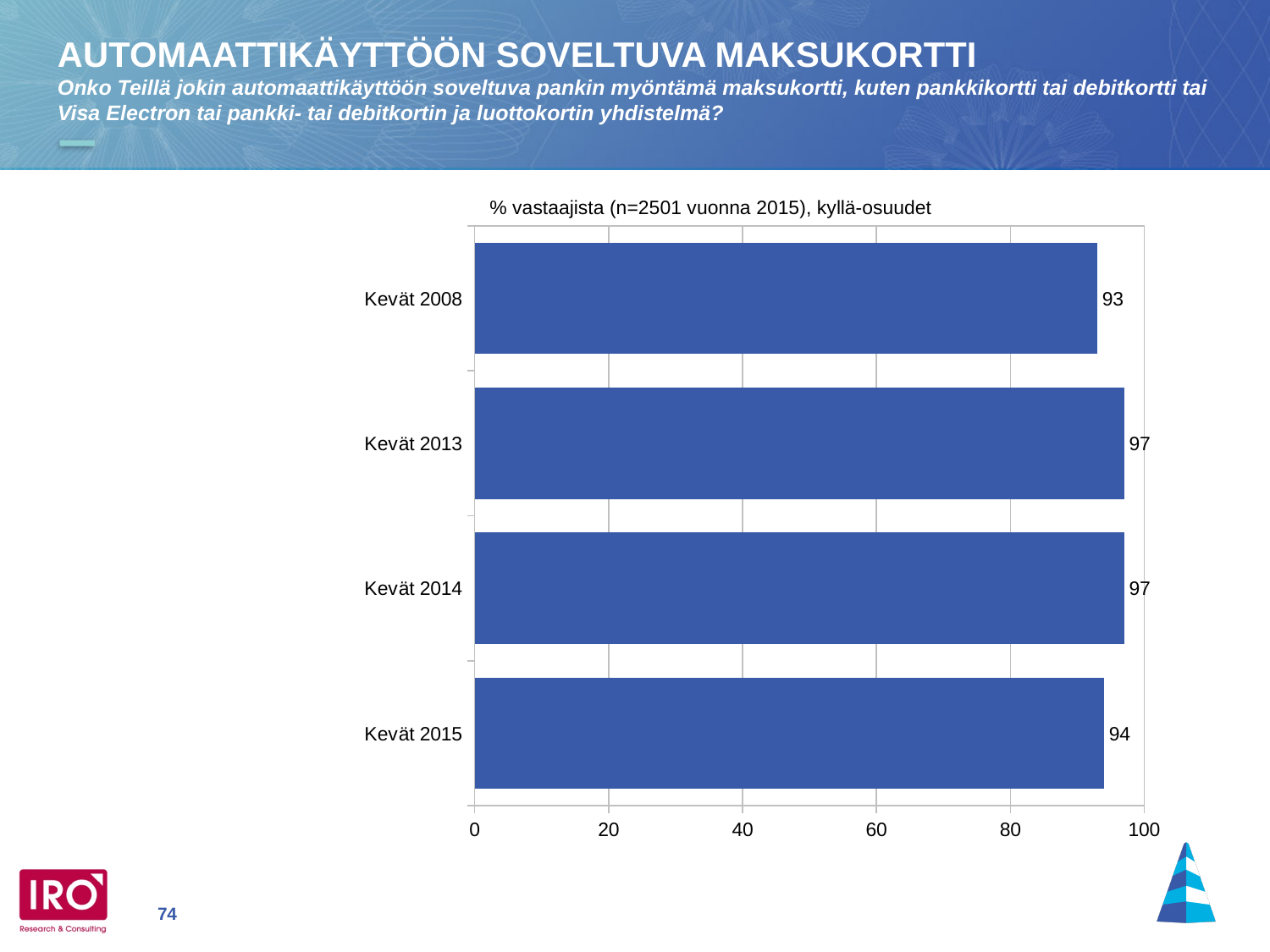
What is the title of the chart? % vastaajista (n=2501 vuonna 2015), kyllä-osuudet What is the highest value shown on the horizontal axis? 100 Which is larger, the value for Kevät 2015 or the value for Kevät 2008? Kevät 2015 How many categories are shown in the chart? 4 Which category has the lowest value? Kevät 2008 What is the value for Kevät 2008? 93 What is the difference between the values for Kevät 2014 and Kevät 2015? 3 What kind of chart is shown on the slide? bar chart What is the difference between the values for Kevät 2013 and Kevät 2008? 4 What is the value for Kevät 2013? 97 What is the value for Kevät 2015? 94 Is the value for Kevät 2014 greater or less than 80? greater